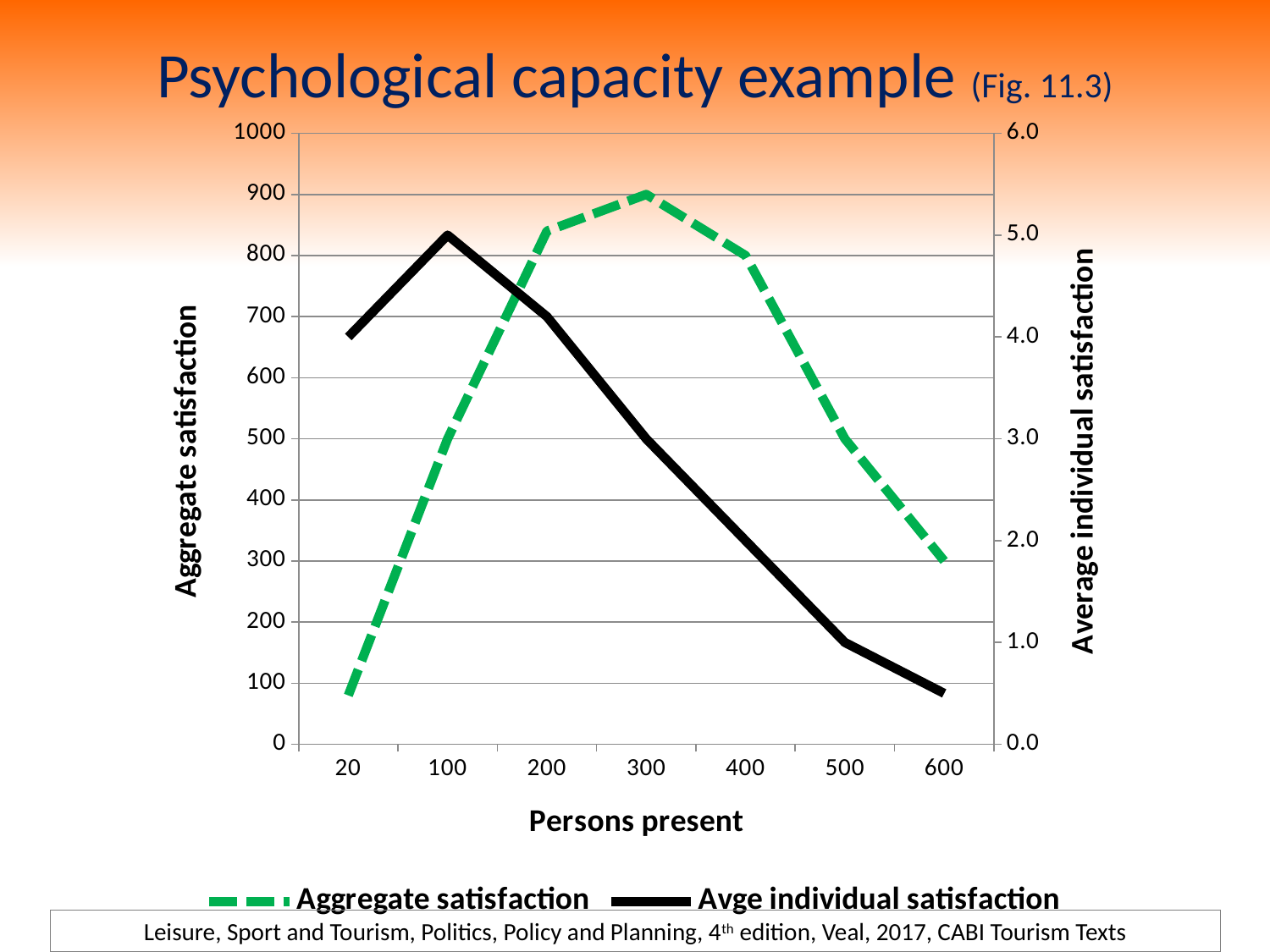
What is the title of the horizontal axis? Persons present At which number of persons present is Avge individual satisfaction lowest? 600 Is the Avge individual satisfaction value at 200 persons present greater or less than 4.0? greater At which number of persons present is Aggregate satisfaction lowest? 20 What is the Aggregate satisfaction value at 300 persons present? 900 At which number of persons present is Avge individual satisfaction highest? 100 How many points along the Persons present axis are plotted for each series? 7 Is the Aggregate satisfaction value at 500 persons present greater or less than 600? less At which number of persons present is Aggregate satisfaction highest? 300 What type of chart is shown on the slide? Line chart How many series does the legend list? 2 Does Avge individual satisfaction rise or fall as persons present increases from 100 to 600? Fall